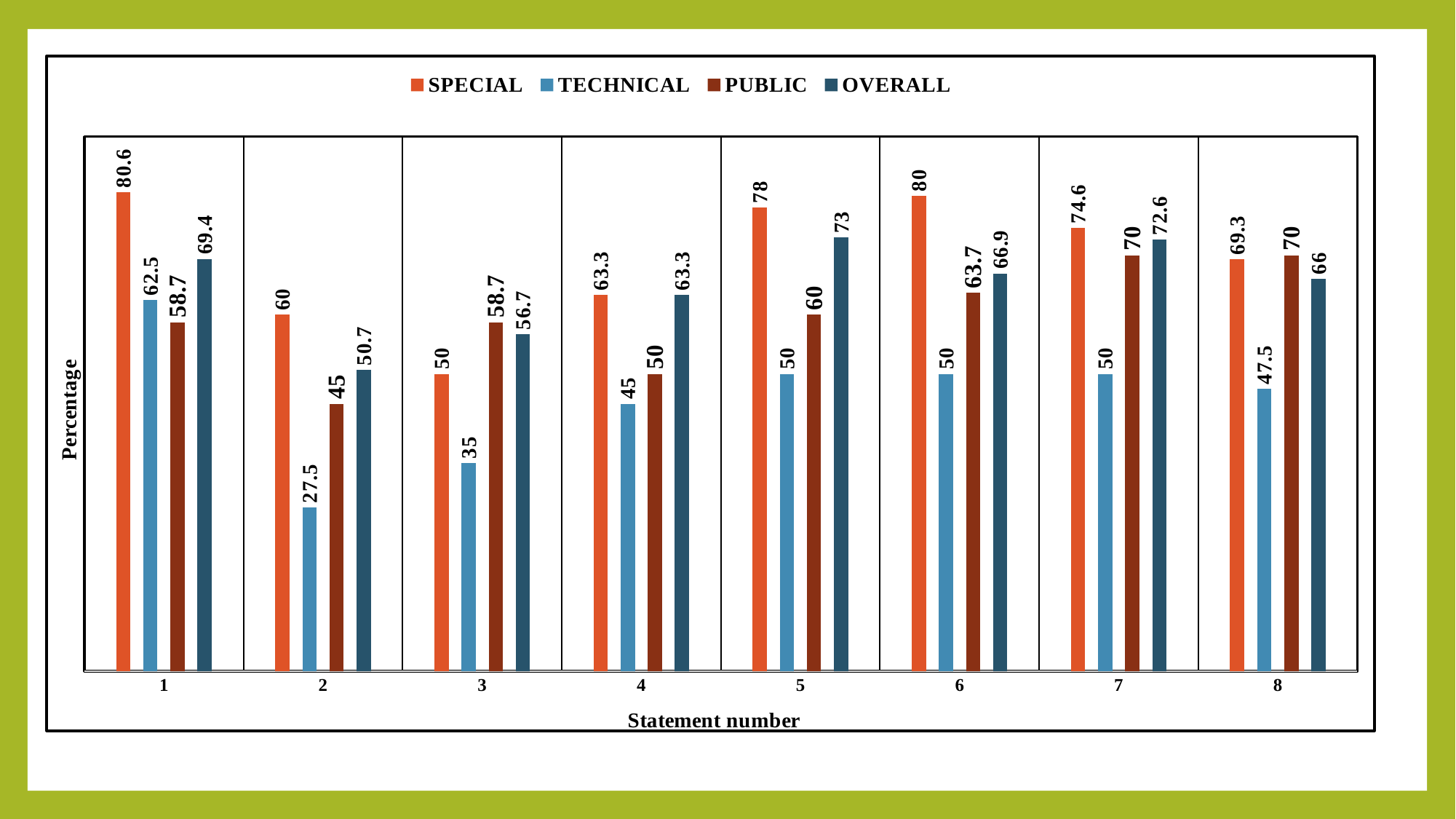
What is the OVERALL value for statement 7? 72.6 What is the TECHNICAL value for statement 2? 27.5 What is the label of the x axis? Statement number Which statement number has the highest SPECIAL value? 1 What is the PUBLIC value for statement 6? 63.7 For statement 3, which is larger, the PUBLIC value or the SPECIAL value? PUBLIC Which statement number has the lowest TECHNICAL value? 2 What kind of chart is shown on the slide? Bar chart How many series does the legend list? 4 How many statement numbers are shown on the x axis? 8 What is the SPECIAL value for statement 1? 80.6 What is the difference between the SPECIAL and TECHNICAL values for statement 2? 32.5